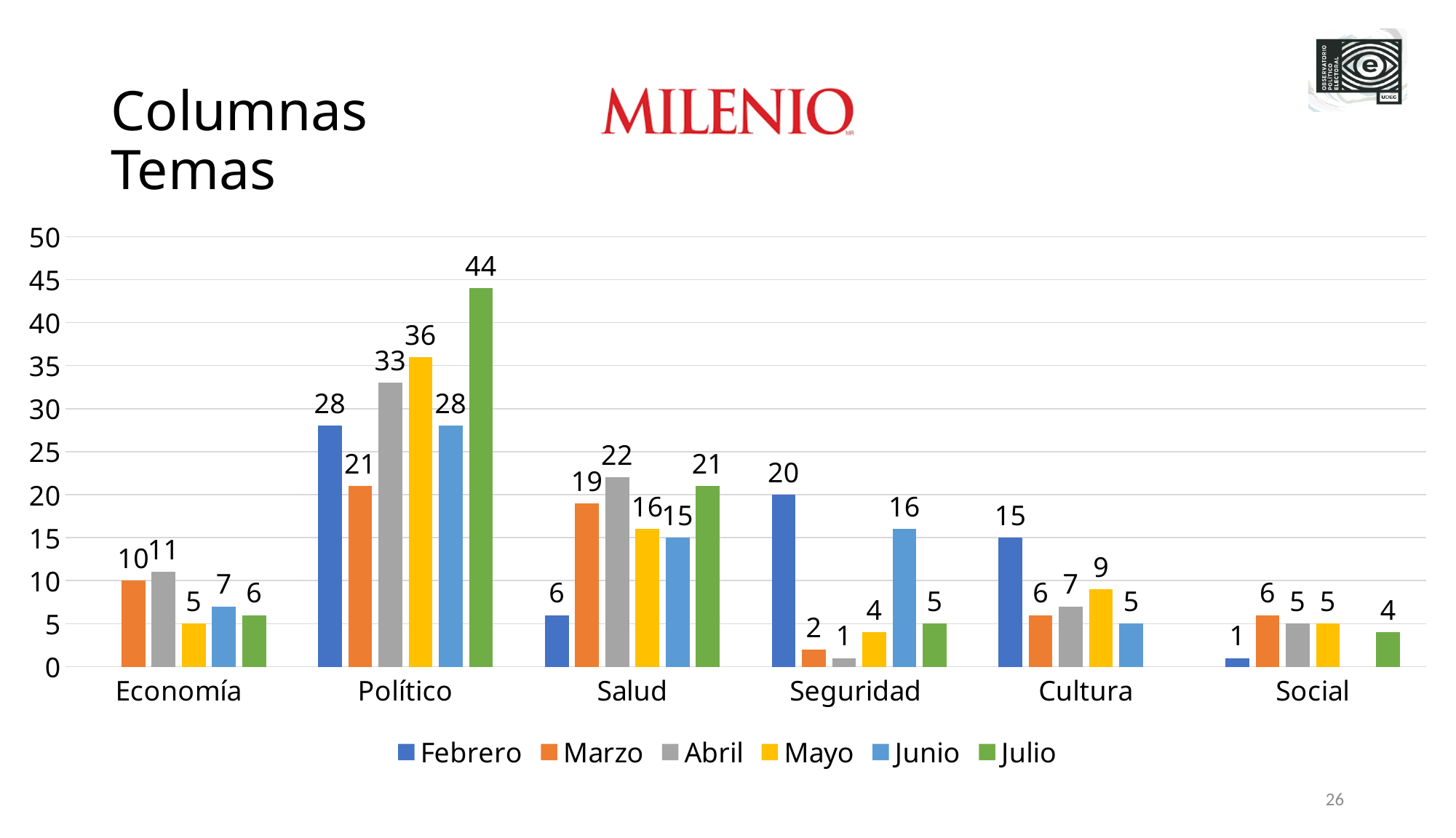
What is the value for Abril in the Salud category? 22 Which colour represents Julio in the legend? Green What is the difference between the Mayo and Marzo values in the Político category? 15 What kind of chart is shown on the slide? Bar chart What is the value for Julio in the Político category? 44 Which month has the highest value in the Político category? Julio Which is larger in the Cultura category, the Febrero value or the Mayo value? Febrero What is the difference between the Junio and Julio values in the Seguridad category? 11 Which month has the lowest value in the Seguridad category? Abril How many series does the legend list? 6 What is the value for Febrero in the Seguridad category? 20 How many categories are shown on the x axis? 6